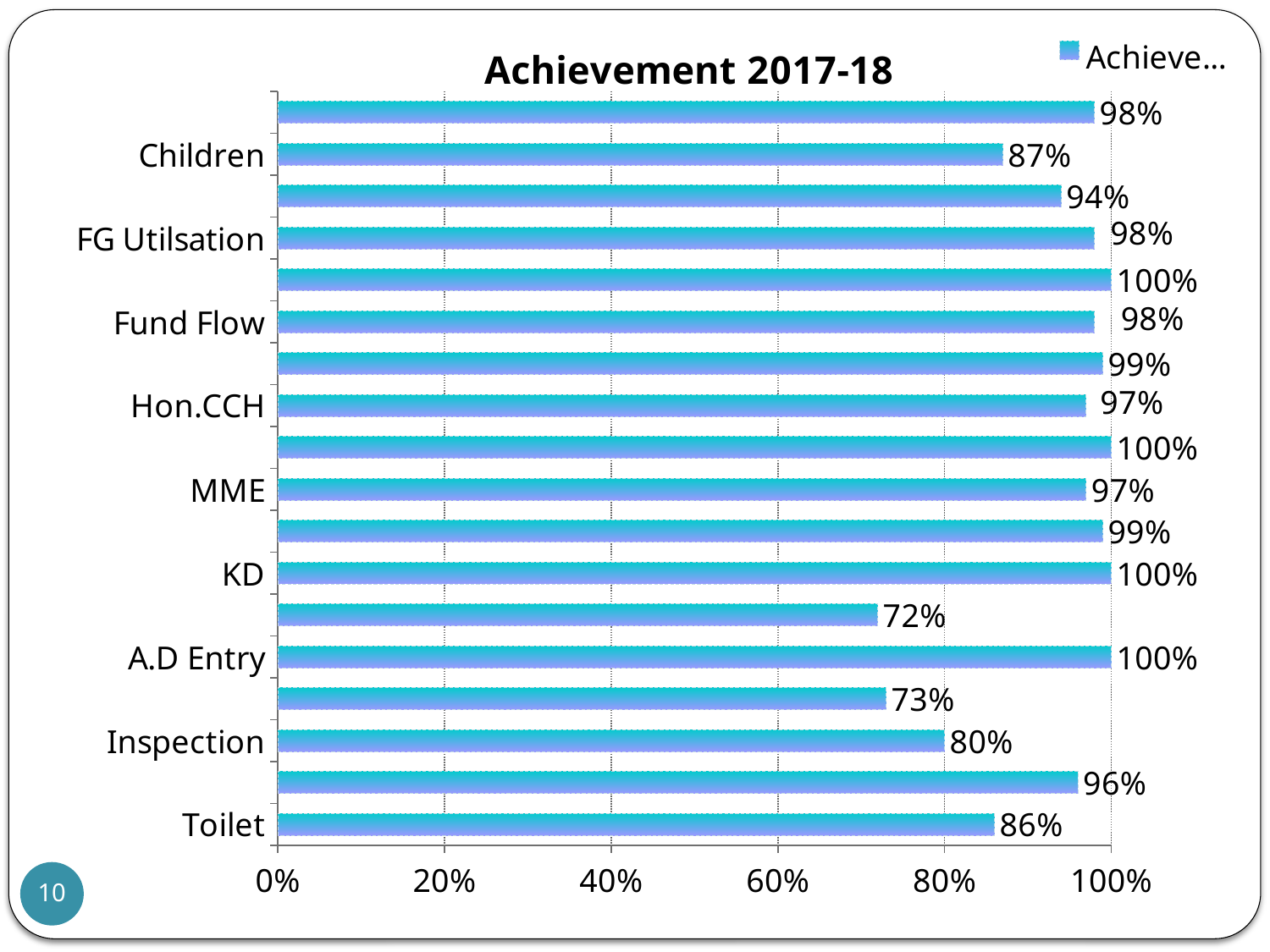
How many bars are plotted in the chart? 18 What is the value for Toilet? 86% What is the value for KD? 100% What is the value for Hon.CCH? 97% What is the difference between the values for Children and Toilet? 1% Which is larger, the value for MME or the value for Inspection? MME Which of the labelled categories has the lowest value? Inspection What is the value for FG Utilsation? 98% What is the value for Inspection? 80% What is the value for Children? 87% What is the title of the chart? Achievement 2017-18 What kind of chart is shown on the slide? bar chart